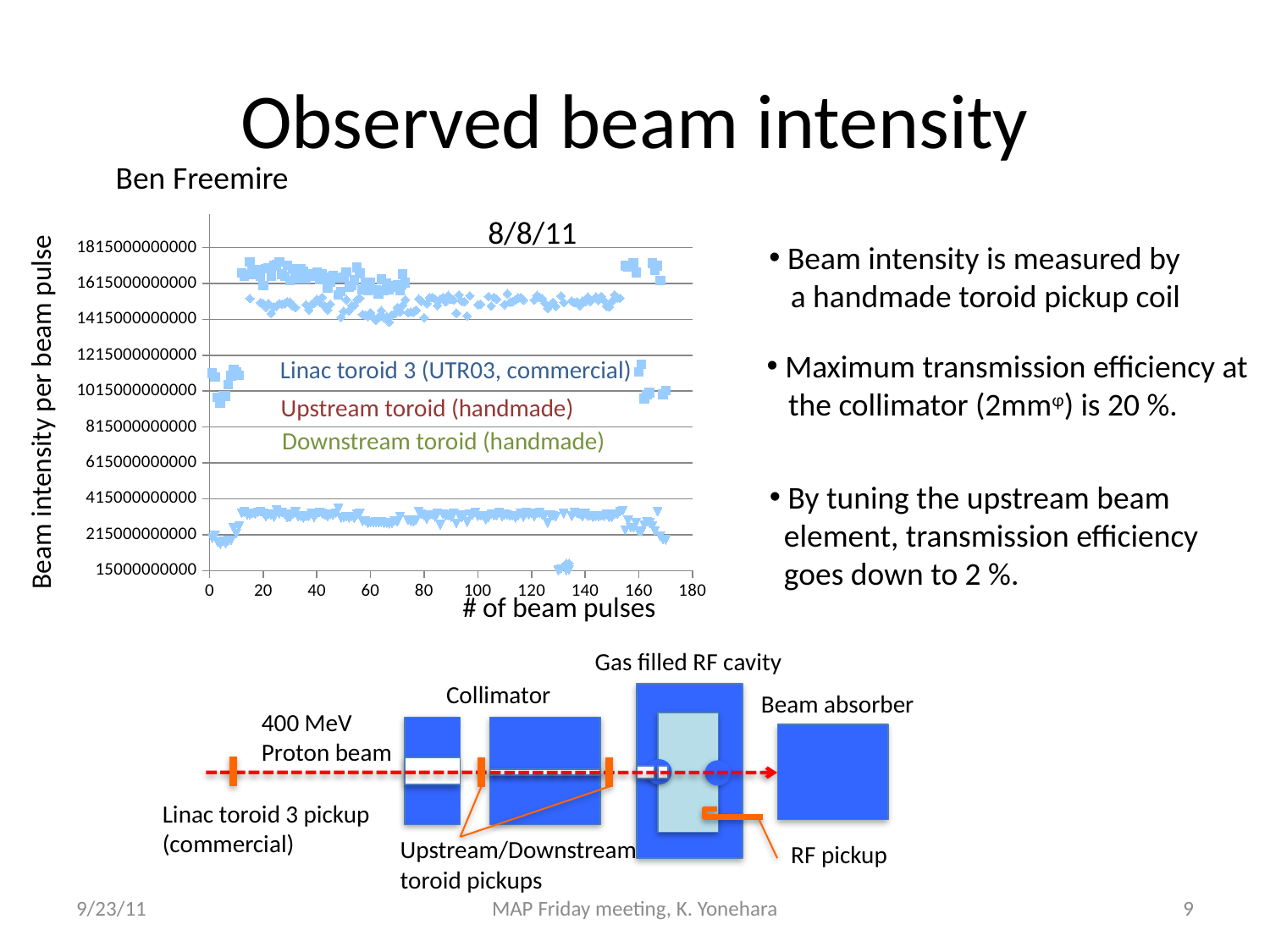
Are the points near x = 5 in the middle of the chart greater or less than 815000000000? greater What is the highest tick value shown on the x axis of the chart? 180 How many series are labelled in the chart? 3 What is the label of the x axis of the chart? # of beam pulses Are the points in the bottom band of the chart (around x = 60) greater or less than 615000000000? less What is the title of the chart? 8/8/11 What kind of chart is shown on the slide? scatter chart What is the lowest tick value shown on the y axis of the chart? 15000000000 Which series label in the chart is described as commercial? Linac toroid 3 (UTR03, commercial) Are the points in the topmost cluster of the chart (around x = 20) greater or less than 1415000000000? greater